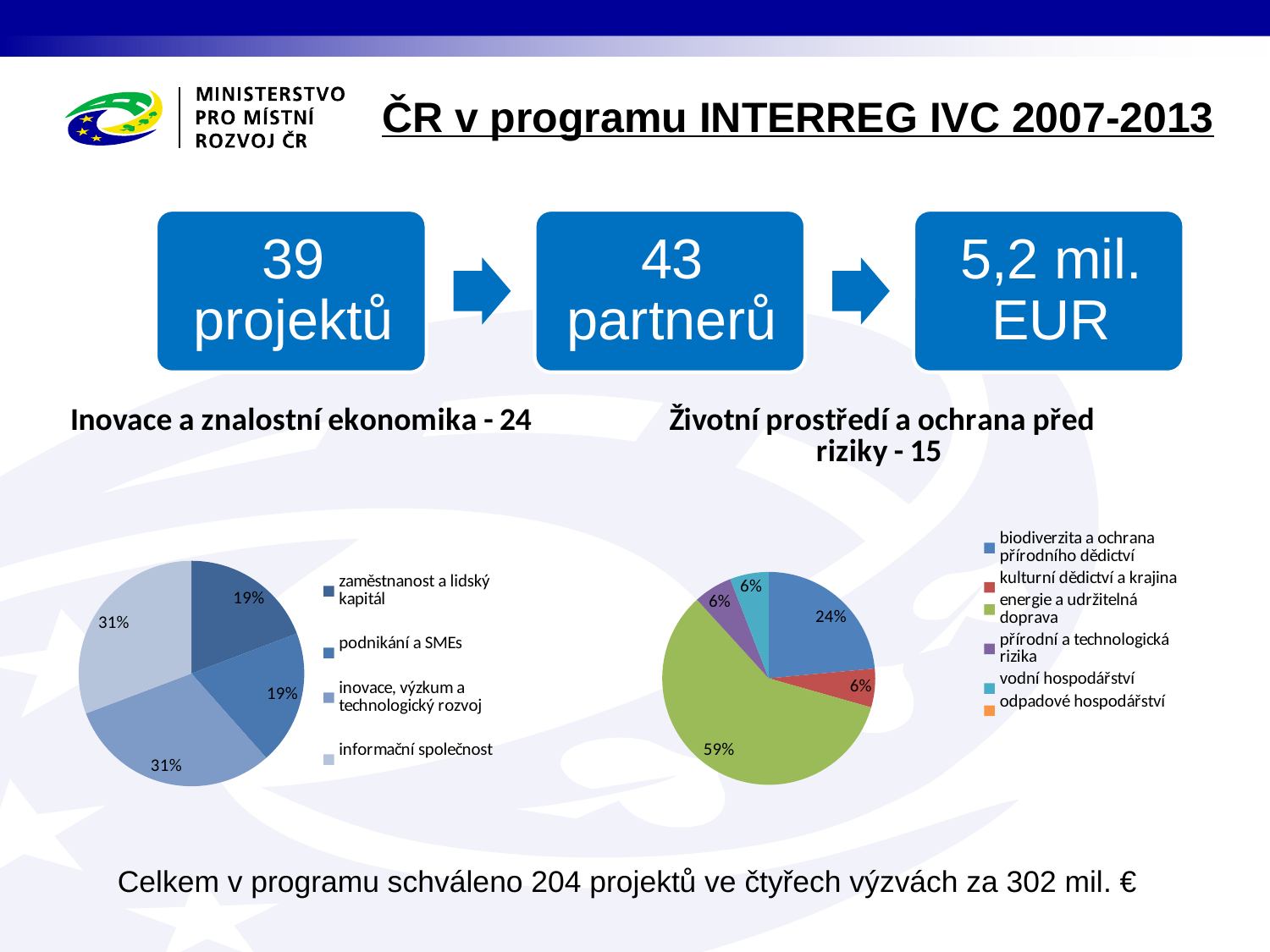
In the pie chart titled "Životní prostředí a ochrana před riziky - 15", which category has the largest slice? energie a udržitelná doprava In the pie chart titled "Životní prostředí a ochrana před riziky - 15", what share does "energie a udržitelná doprava" have? 59% In the pie chart titled "Životní prostředí a ochrana před riziky - 15", what share does "biodiverzita a ochrana přírodního dědictví" have? 24% In the pie chart titled "Životní prostředí a ochrana před riziky - 15", what is the difference between the shares of "energie a udržitelná doprava" and "biodiverzita a ochrana přírodního dědictví"? 35 percentage points What type of chart is used under the heading "Inovace a znalostní ekonomika - 24"? Pie chart In the pie chart titled "Inovace a znalostní ekonomika - 24", what share does "zaměstnanost a lidský kapitál" have? 19% In the pie chart titled "Inovace a znalostní ekonomika - 24", which is larger: "podnikání a SMEs" or "inovace, výzkum a technologický rozvoj"? inovace, výzkum a technologický rozvoj How many entries does the legend of the pie chart titled "Životní prostředí a ochrana před riziky - 15" list? 6 In the pie chart titled "Inovace a znalostní ekonomika - 24", what share does "informační společnost" have? 31% How many entries does the legend of the pie chart titled "Inovace a znalostní ekonomika - 24" list? 4 In the pie chart titled "Inovace a znalostní ekonomika - 24", what is the difference between the shares of "informační společnost" and "podnikání a SMEs"? 12 percentage points In the pie chart titled "Životní prostředí a ochrana před riziky - 15", what share does "kulturní dědictví a krajina" have? 6%